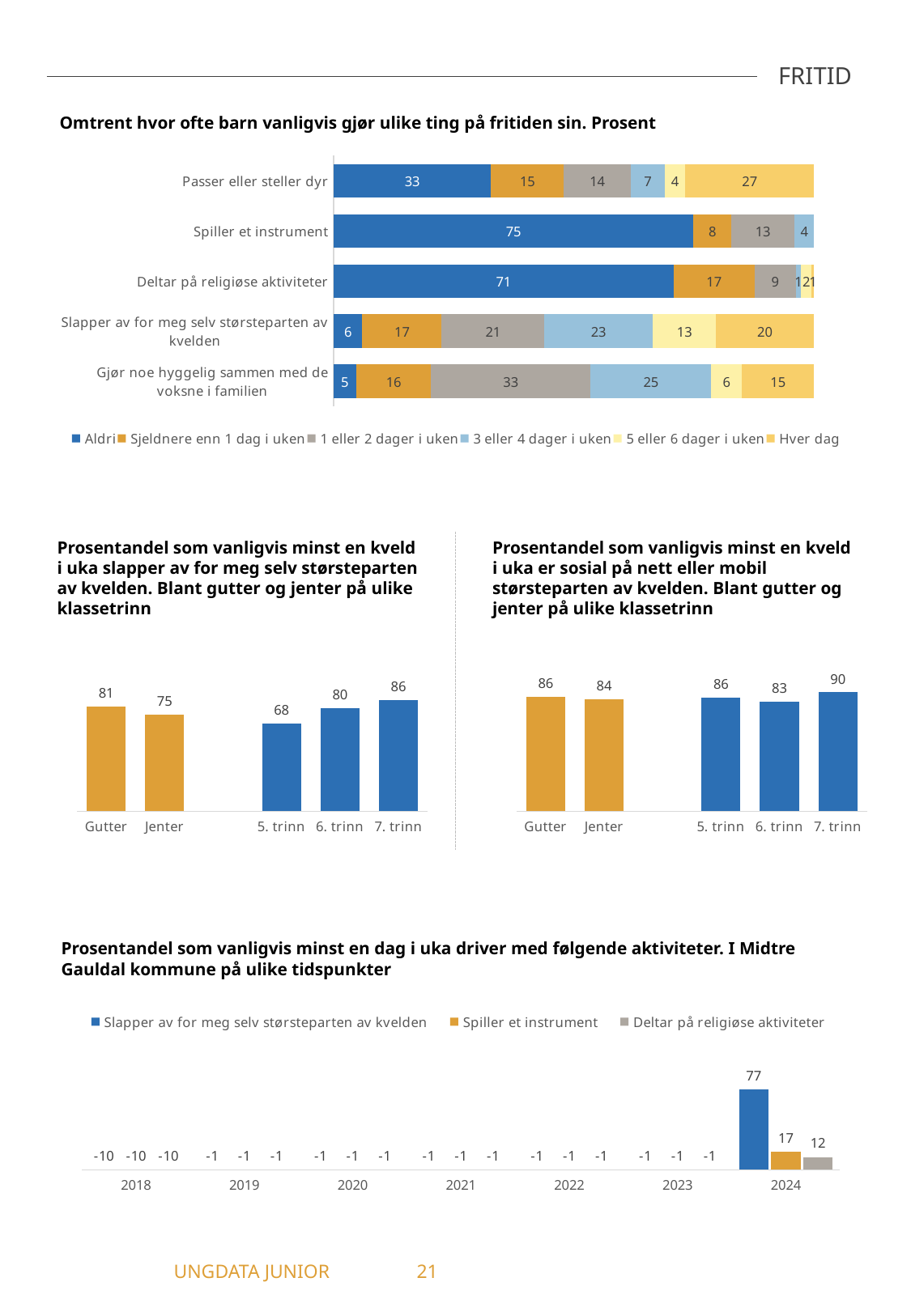
In the chart 'Omtrent hvor ofte barn vanligvis gjør ulike ting på fritiden sin', what is the value of 'Aldri' for 'Spiller et instrument'? 75 In the chart 'Omtrent hvor ofte barn vanligvis gjør ulike ting på fritiden sin', what is the difference between the '1 eller 2 dager i uken' values for 'Gjør noe hyggelig sammen med de voksne i familien' and 'Slapper av for meg selv størsteparten av kvelden'? 12 In the chart 'Omtrent hvor ofte barn vanligvis gjør ulike ting på fritiden sin', how many series does the legend list? 6 In the bottom-right chart about being social online or on mobile most of the evening, which group has the highest value? 7. trinn In the chart 'Prosentandel som vanligvis minst en dag i uka driver med følgende aktiviteter', what is the 2024 value for 'Spiller et instrument'? 17 In the bottom-right chart about being social online or on mobile most of the evening, which is larger: 'Gutter' or 'Jenter'? Gutter In the bottom-left chart about relaxing alone most of the evening, what is the difference between 'Gutter' and 'Jenter'? 6 In the chart 'Omtrent hvor ofte barn vanligvis gjør ulike ting på fritiden sin', which activity has the highest 'Aldri' value? Spiller et instrument In the bottom-left chart about relaxing alone most of the evening, what is the value for '5. trinn'? 68 In the chart 'Omtrent hvor ofte barn vanligvis gjør ulike ting på fritiden sin', how many activities (categories) are shown? 5 In the bottom-left chart about relaxing alone most of the evening, which group has the lowest value? 5. trinn In the chart 'Omtrent hvor ofte barn vanligvis gjør ulike ting på fritiden sin', what is the value of 'Hver dag' for 'Passer eller steller dyr'? 27